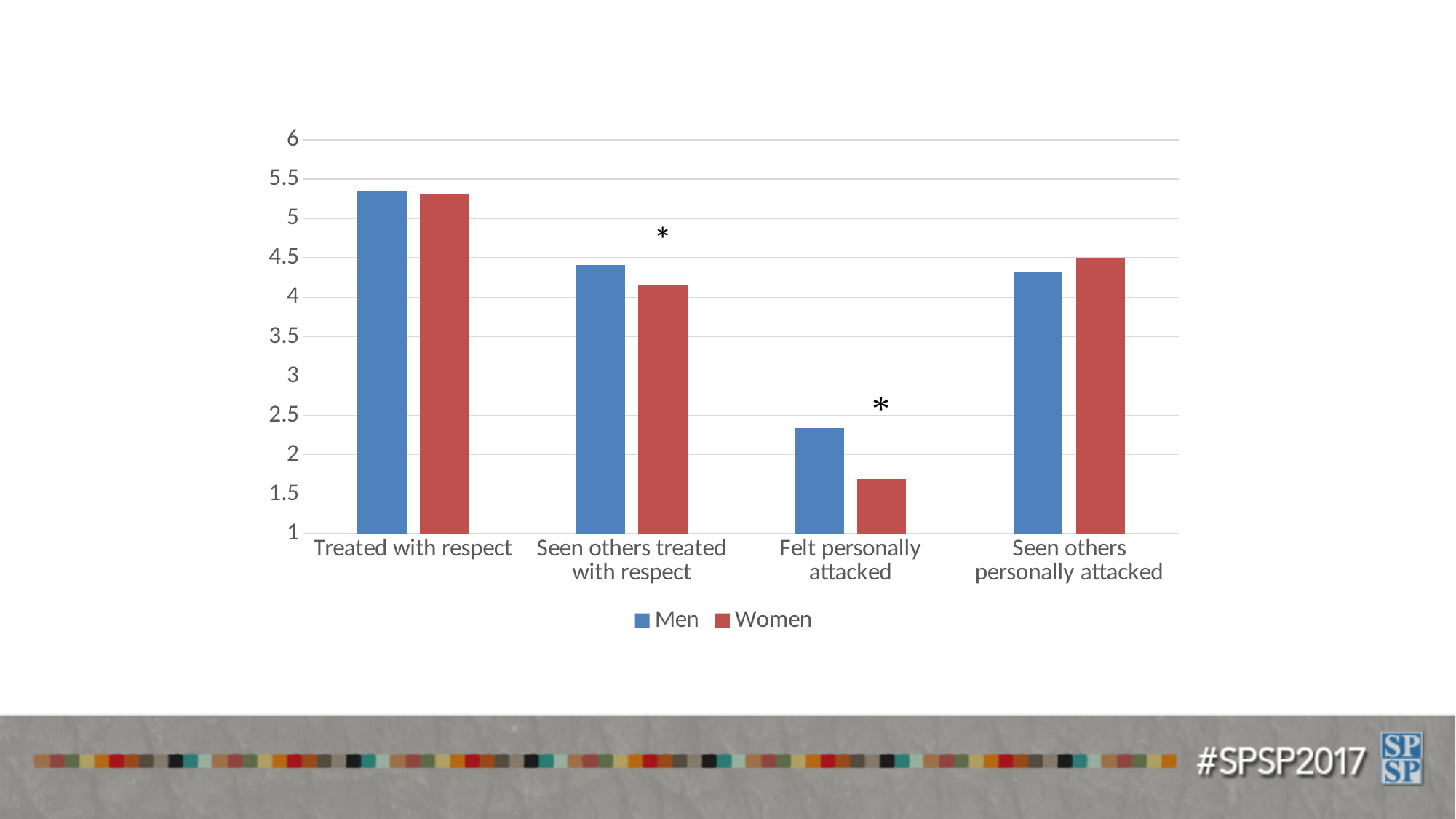
How many categories are shown on the x axis? 4 Is the value for Women in Felt personally attacked greater or less than 2? less What kind of chart is shown on the slide? bar chart For Seen others personally attacked, which series has the larger value, Men or Women? Women Which category has the lowest value for Men? Felt personally attacked Which category has the lowest value for Women? Felt personally attacked Is the value for Men in Treated with respect greater or less than 5? greater For Seen others treated with respect, which series has the larger value, Men or Women? Men How many series does the legend list? 2 For Felt personally attacked, which series has the larger value, Men or Women? Men Which category has the highest value for Men? Treated with respect Which colour represents the Women series in the legend? red